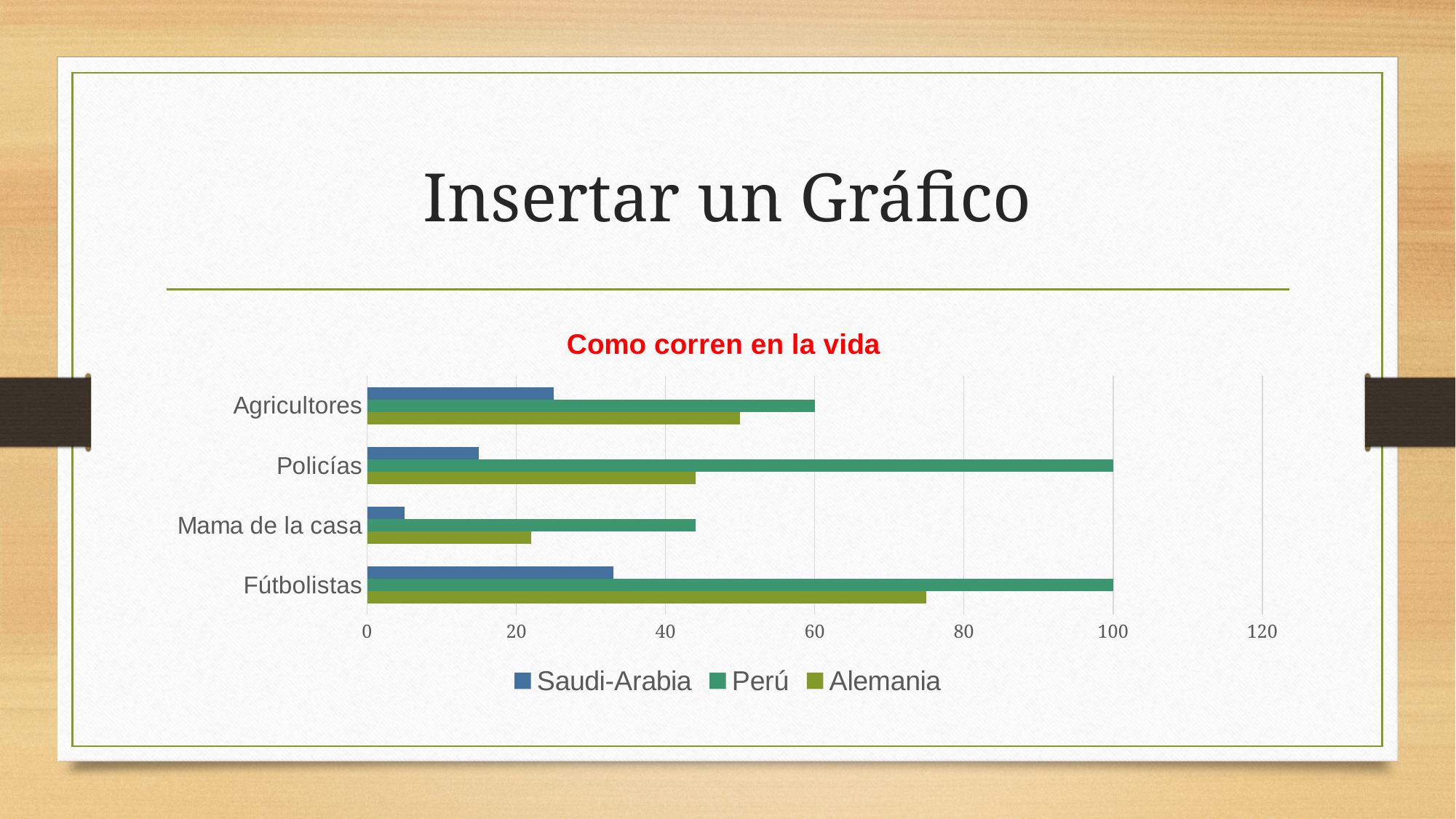
How many categories are shown on the chart? 4 Is the value for Saudi-Arabia in the Mama de la casa category greater or less than 20? less What is the title of the chart? Como corren en la vida What is the value for Perú in the Fútbolistas category? 100 Which series has the highest value in the Agricultores category? Perú For the Saudi-Arabia series, which category has the lowest value? Mama de la casa How many series does the legend list? 3 What type of chart is shown on the slide? bar chart Is the value for Alemania in the Fútbolistas category greater or less than 60? greater What is the value for Perú in the Agricultores category? 60 In the Policías category, which is larger: Perú or Alemania? Perú What is the value for Perú in the Policías category? 100